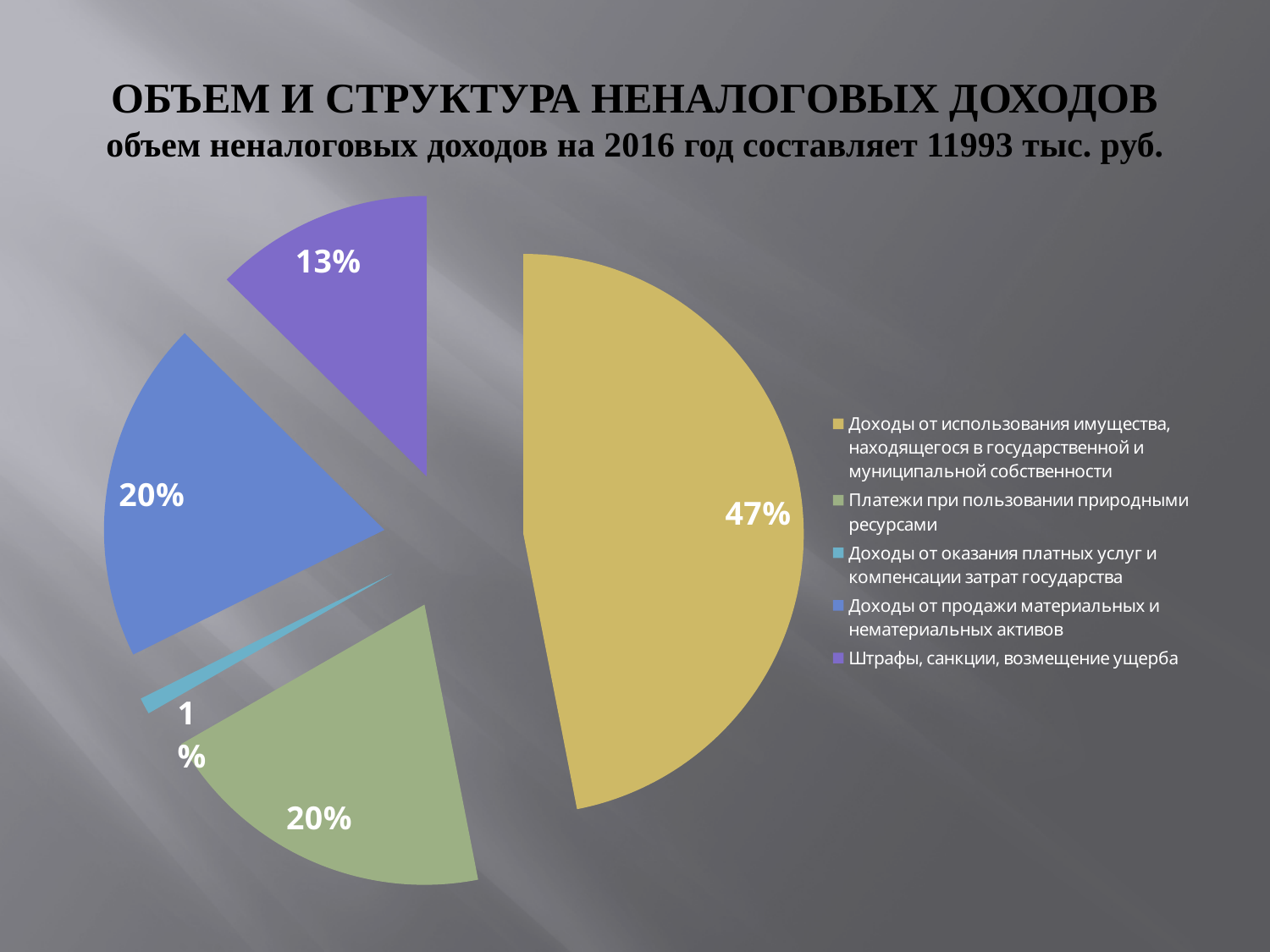
What share of the pie is labelled for "Штрафы, санкции, возмещение ущерба"? 13% What kind of chart is shown on the slide? pie chart What is the difference in percentage points between the slice for "Доходы от использования имущества, находящегося в государственной и муниципальной собственности" and the slice for "Штрафы, санкции, возмещение ущерба"? 34 percentage points What share of the pie is labelled for "Доходы от оказания платных услуг и компенсации затрат государства"? 1% How many entries does the legend list? 5 What share of the pie is labelled for "Доходы от использования имущества, находящегося в государственной и муниципальной собственности"? 47% How many slices does the pie chart have? 5 Which category has the smallest slice of the pie? Доходы от оказания платных услуг и компенсации затрат государства Which is larger: the slice for "Доходы от продажи материальных и нематериальных активов" or the slice for "Штрафы, санкции, возмещение ущерба"? Доходы от продажи материальных и нематериальных активов Which category has the largest slice of the pie? Доходы от использования имущества, находящегося в государственной и муниципальной собственности What share of the pie is labelled for "Платежи при пользовании природными ресурсами"? 20% According to the slide subtitle, what is the total volume of non-tax revenues for 2016? 11993 тыс. руб.